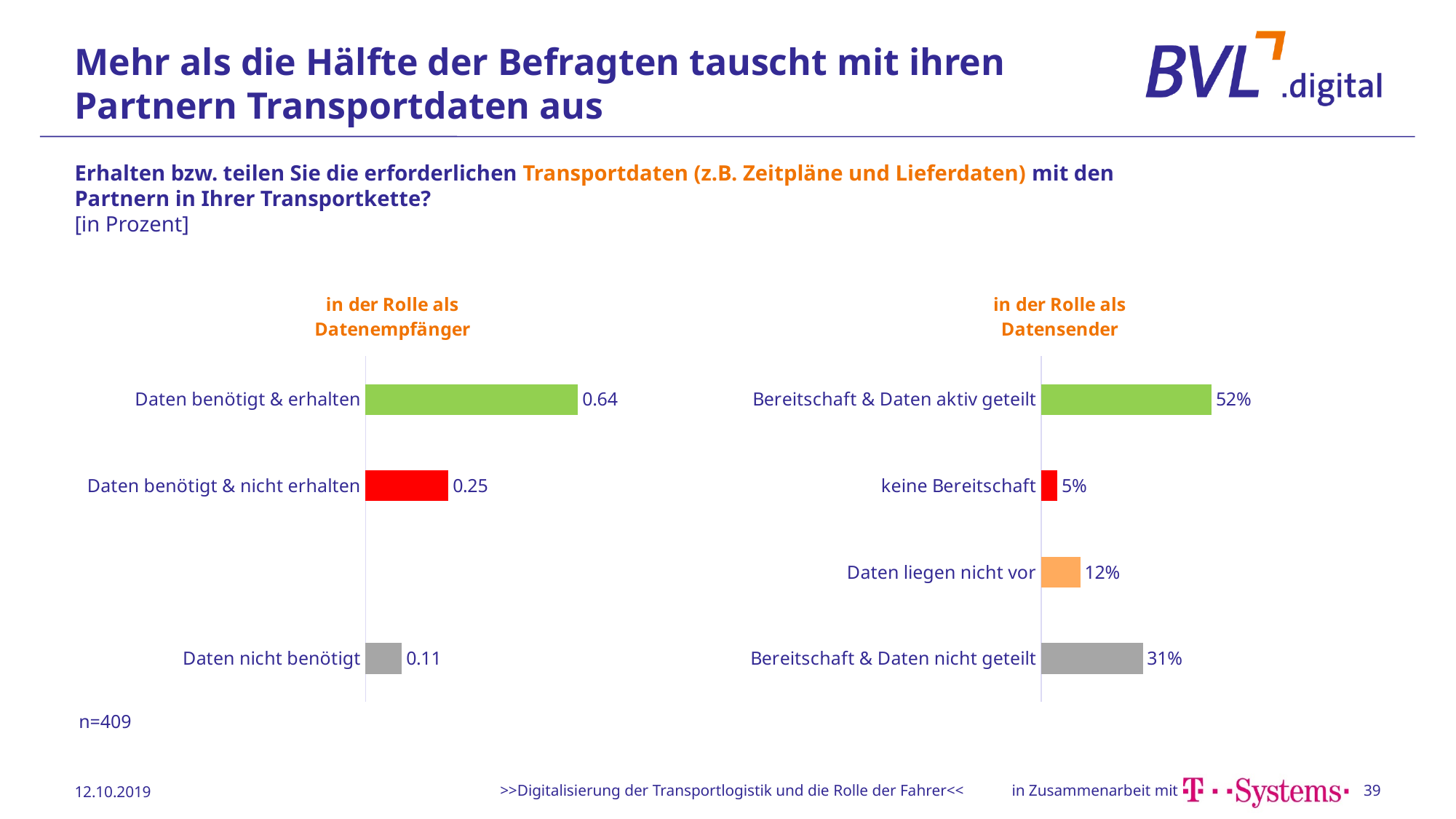
In the 'in der Rolle als Datenempfänger' chart, what is the value for 'Daten benötigt & erhalten'? 0.64 In the 'in der Rolle als Datensender' chart, which is larger: 'Daten liegen nicht vor' or 'keine Bereitschaft'? Daten liegen nicht vor In the 'in der Rolle als Datensender' chart, what is the difference between 'Bereitschaft & Daten aktiv geteilt' and 'Bereitschaft & Daten nicht geteilt'? 21% In the 'in der Rolle als Datensender' chart, what is the value for 'Daten liegen nicht vor'? 12% How many categories are shown in the 'in der Rolle als Datenempfänger' chart? 3 In the 'in der Rolle als Datenempfänger' chart, what is the value for 'Daten nicht benötigt'? 0.11 In the 'in der Rolle als Datenempfänger' chart, what is the difference between 'Daten benötigt & erhalten' and 'Daten benötigt & nicht erhalten'? 0.39 How many categories are shown in the 'in der Rolle als Datensender' chart? 4 In the 'in der Rolle als Datensender' chart, what is the value for 'Bereitschaft & Daten nicht geteilt'? 31% In the 'in der Rolle als Datensender' chart, which category has the lowest value? keine Bereitschaft What type of chart is the 'in der Rolle als Datenempfänger' chart? Bar chart In the 'in der Rolle als Datenempfänger' chart, which category has the highest value? Daten benötigt & erhalten